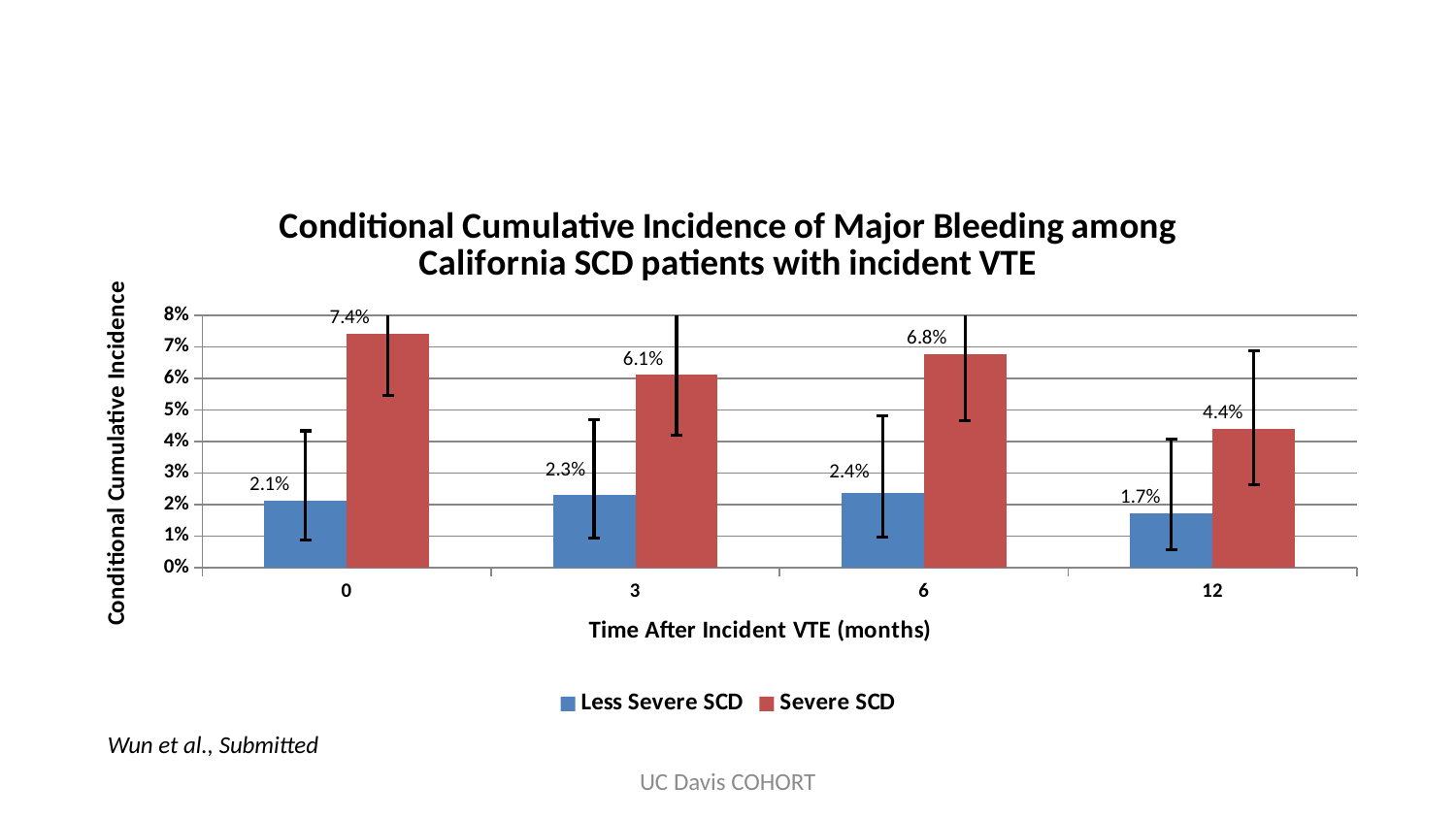
How many series does the legend list? 2 Is the Severe SCD value at 12 months greater or less than 4%? greater What is the value for Severe SCD at 6 months? 6.8% What is the difference between the Severe SCD and Less Severe SCD values at 3 months? 3.8% What is the label of the x axis? Time After Incident VTE (months) Which is larger at 12 months: the Severe SCD value or the Less Severe SCD value? Severe SCD What kind of chart is shown on the slide? Bar chart At which time point is the Less Severe SCD value lowest? 12 What is the conditional cumulative incidence for Severe SCD at 0 months after incident VTE? 7.4% At which time point is the Severe SCD value highest? 0 How many time points are shown on the x axis? 4 What is the conditional cumulative incidence for Less Severe SCD at 12 months after incident VTE? 1.7%